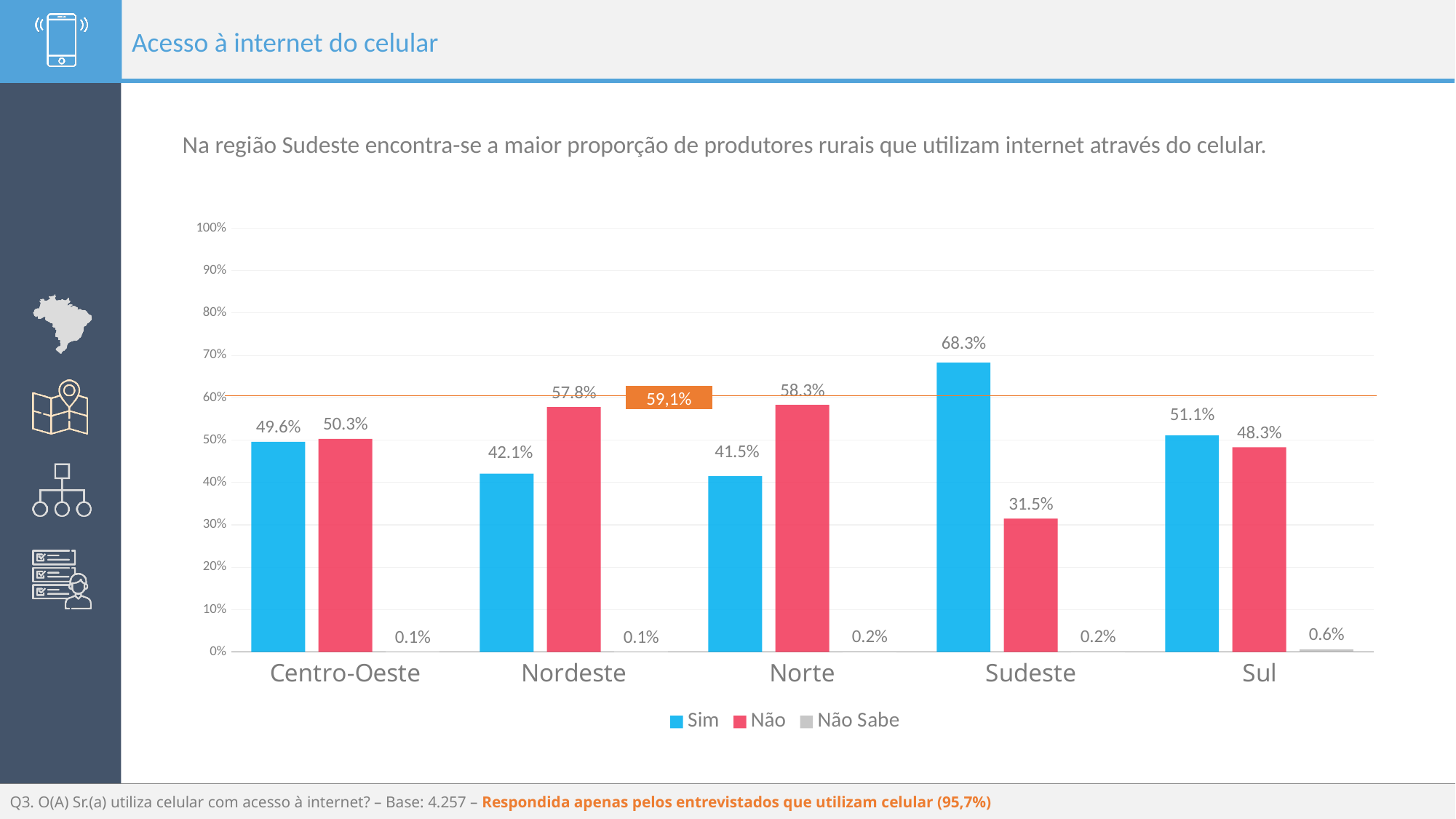
What kind of chart is shown on the slide? Bar chart What is the value of "Não" for Nordeste? 57.8% Is the "Sim" value for Sudeste greater or less than 60%? greater Which region has the lowest "Não" value? Sudeste What is the value of "Sim" for Sudeste? 68.3% How many regions are shown on the x axis? 5 What is the value of "Não Sabe" for Sul? 0.6% Which region has the highest "Sim" value? Sudeste Which is larger for Norte: the "Sim" value or the "Não" value? Não What value is shown in the orange box on the horizontal reference line? 59,1% What is the difference between the "Sim" and "Não" values for Sudeste? 36.8 percentage points How many series does the legend list? 3